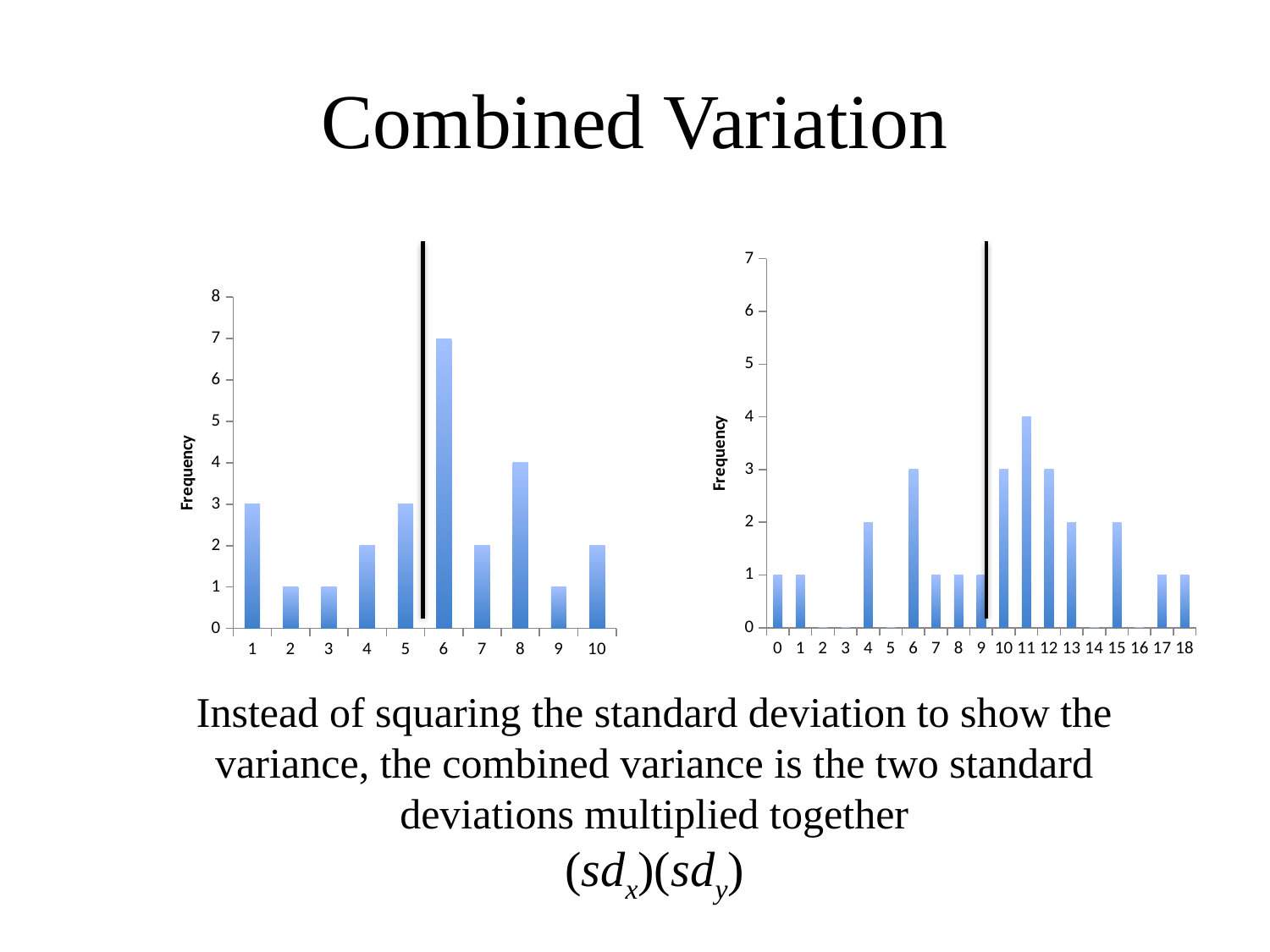
In the left chart, what is the frequency for category 8? 4 In the right chart, which category has the highest frequency? 11 In the left chart, what is the difference between the frequency for category 6 and the frequency for category 8? 3 In the left chart, which is larger, the frequency for category 1 or the frequency for category 4? category 1 What is the label on the vertical axis of the right chart? Frequency What type of chart is the left chart? bar chart In the right chart, how many categories are labelled on the x axis? 19 In the left chart, which category has the highest frequency? 6 In the left chart, what is the frequency for category 6? 7 In the right chart, what is the frequency for category 4? 2 In the right chart, what is the frequency for category 11? 4 In the left chart, how many categories are shown on the x axis? 10